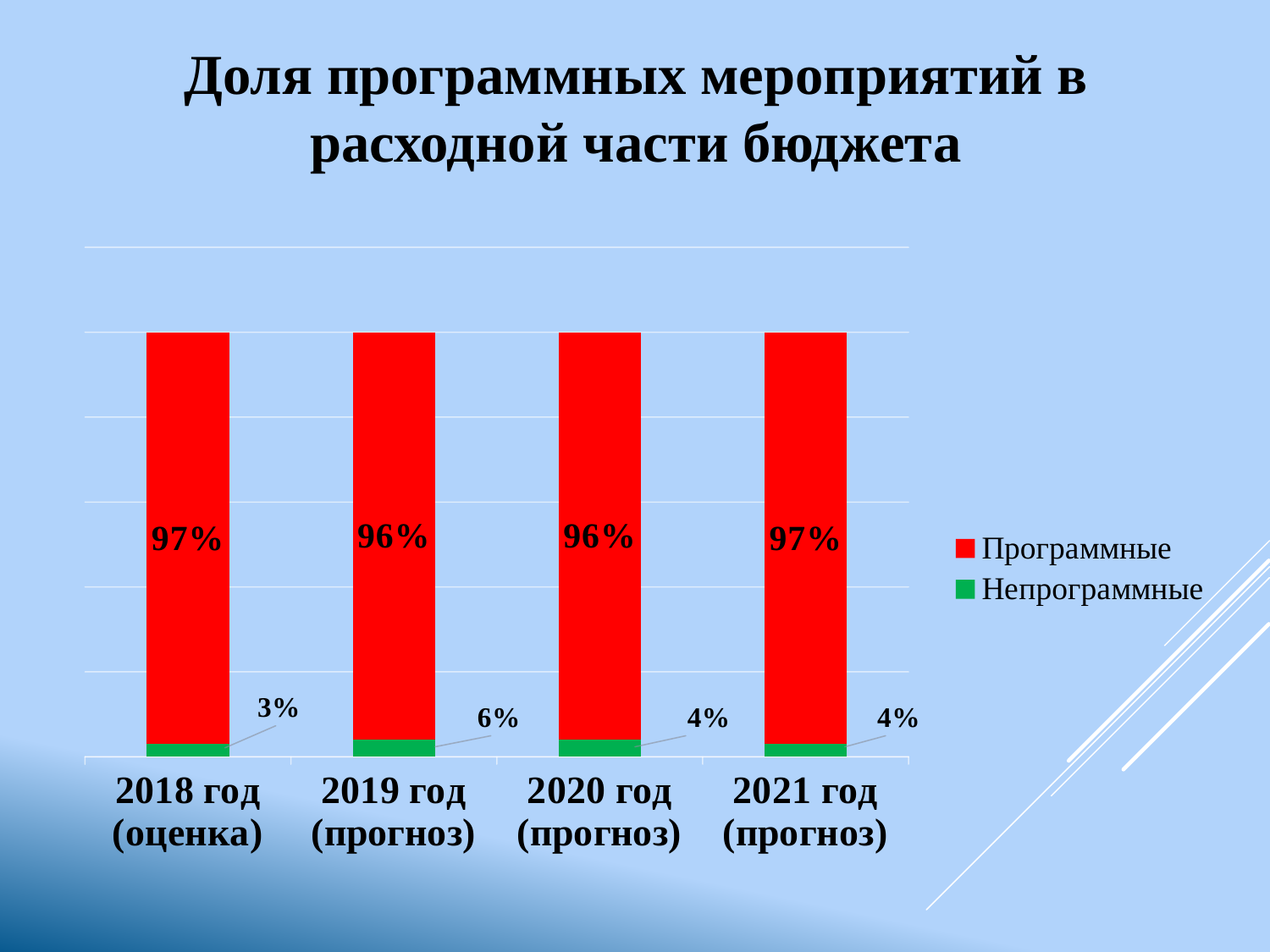
How many categories are shown on the x axis? 4 How many series does the legend list? 2 What is the value for Программные in 2020 год (прогноз)? 96% What is the value for Непрограммные in 2021 год (прогноз)? 4% What is the value for Непрограммные in 2018 год (оценка)? 3% What is the value for Программные in 2018 год (оценка)? 97% What kind of chart is shown on the slide? Stacked bar chart What is the value for Непрограммные in 2019 год (прогноз)? 6% In which year is the Непрограммные share highest? 2019 год (прогноз) What is the difference between the Непрограммные values for 2019 год (прогноз) and 2018 год (оценка)? 3% In which year is the Непрограммные share lowest? 2018 год (оценка) Which is larger: the Программные value for 2018 год (оценка) or for 2019 год (прогноз)? 2018 год (оценка)